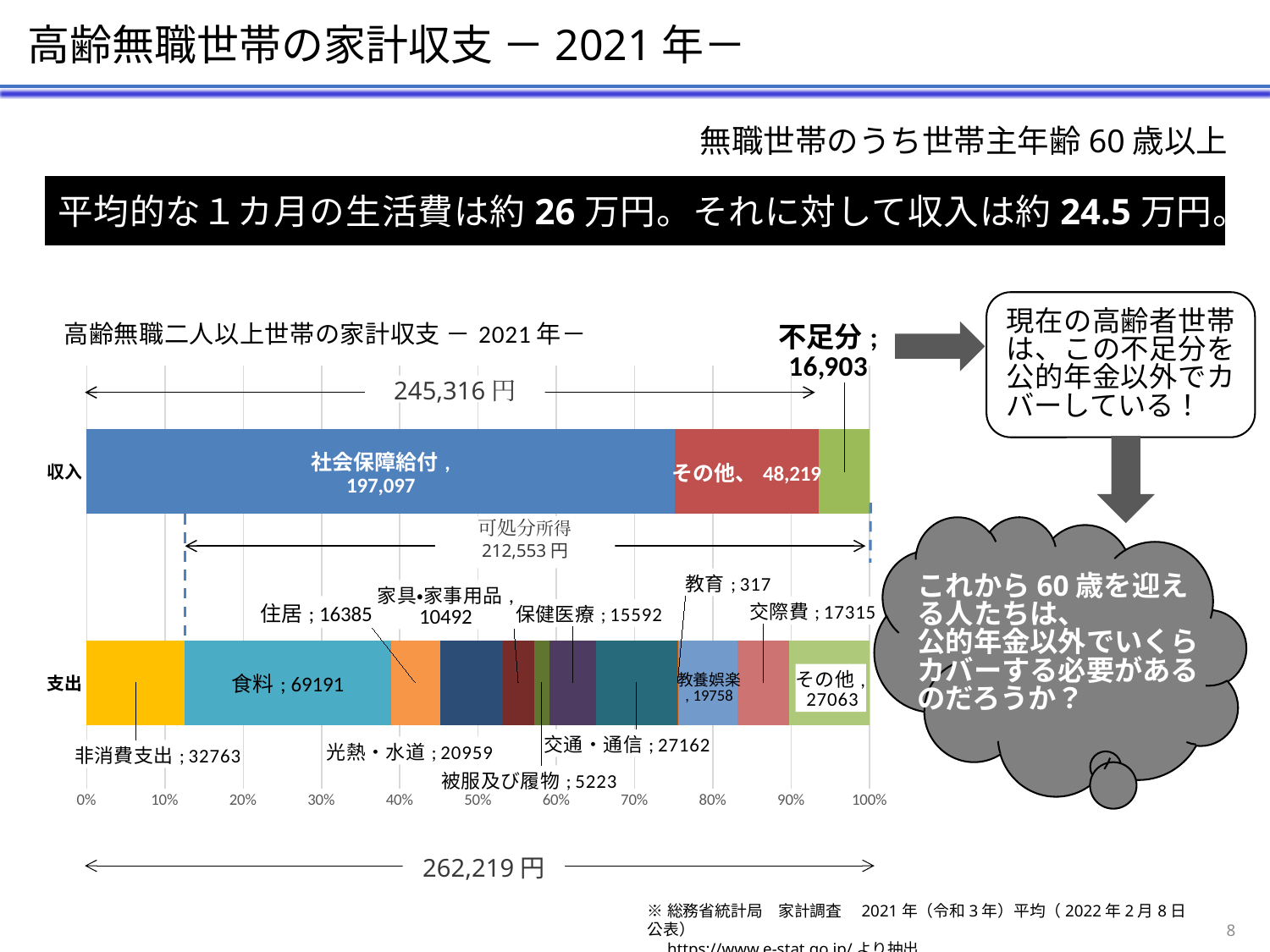
What type of chart is shown on the slide? Stacked bar chart What is the value of 食料 in the 支出 bar? 69191 What is the value of その他 in the 収入 bar? 48,219 What is the value of 社会保障給付 in the 収入 bar? 197,097 Which segment of the 支出 bar has the smallest value? 教育 Which segment of the 支出 bar has the largest value? 食料 What is the value of 教育 in the 支出 bar? 317 What is the difference between 交通・通信 and 光熱・水道 in the 支出 bar? 6203 What is the total amount shown for the 支出 bar? 262,219 円 How many segments make up the 支出 bar? 12 Which is larger in the 支出 bar, 交際費 or 住居? 交際費 What is the value of 不足分 shown at the end of the 収入 bar? 16,903